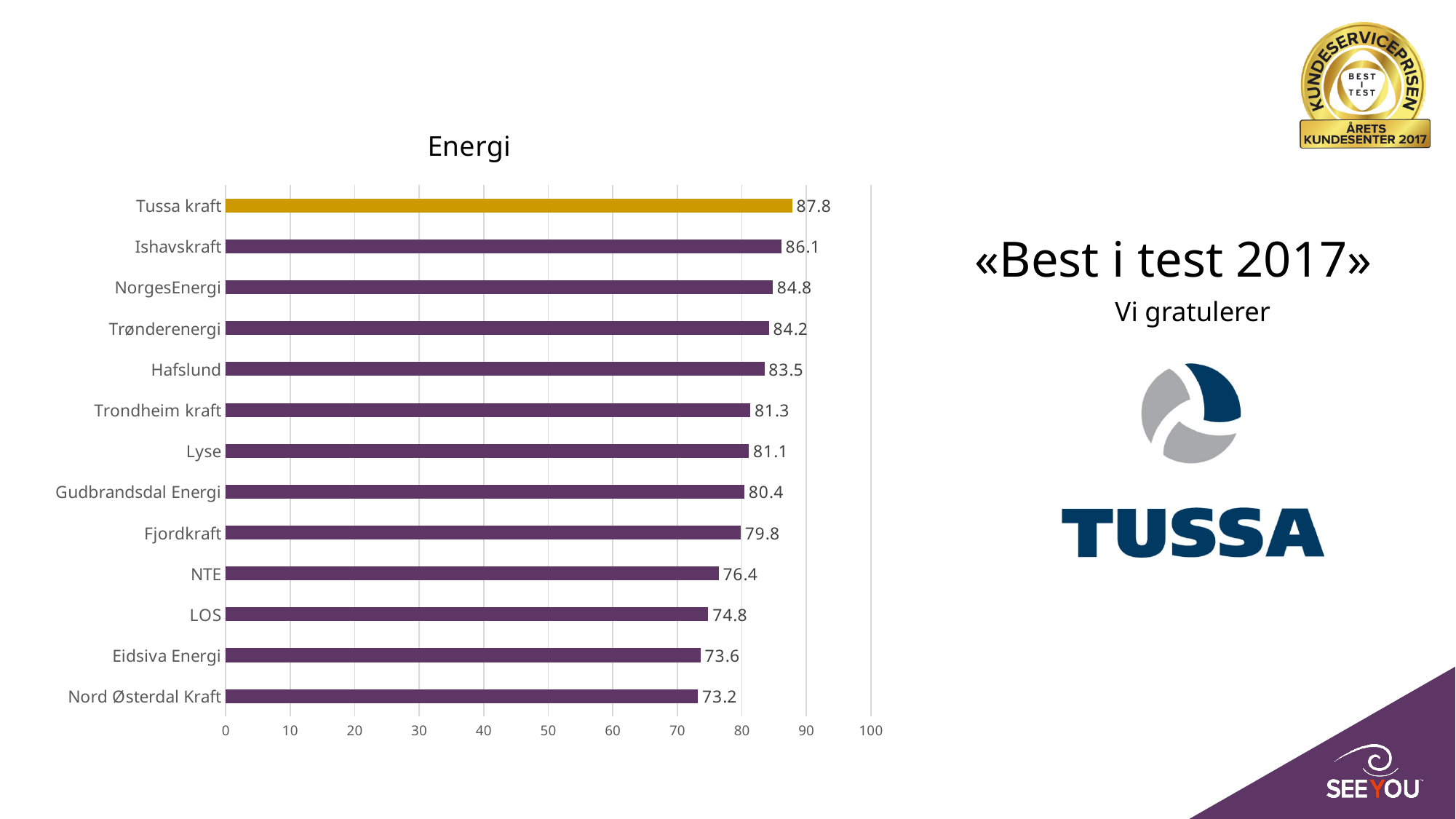
What is the value for Hafslund? 83.5 What is the value for Tussa kraft? 87.8 How many categories are shown in the chart? 13 What is the difference between the values for NTE and LOS? 1.6 Which has a larger value, Lyse or Eidsiva Energi? Lyse What kind of chart is shown on the slide? Bar chart Which category has the highest value? Tussa kraft What is the difference between the values for Tussa kraft and Ishavskraft? 1.7 What is the title of the chart? Energi Is the value for Gudbrandsdal Energi greater or less than 70? greater Which category has the lowest value? Nord Østerdal Kraft What is the value for Fjordkraft? 79.8